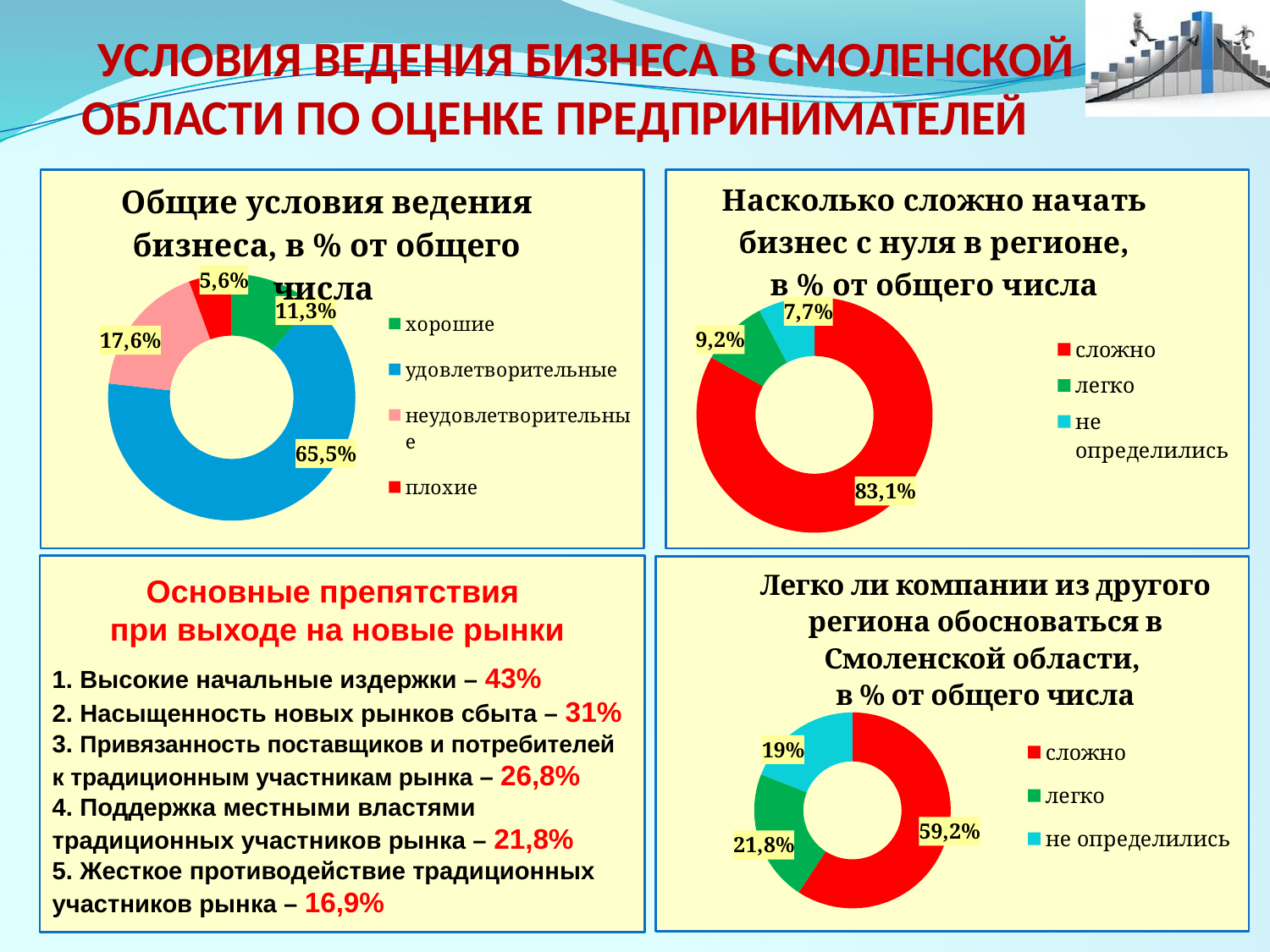
In the top-left chart 'Общие условия ведения бизнеса', which category has the largest share? удовлетворительные In the top-left chart 'Общие условия ведения бизнеса', what is the difference between 'неудовлетворительные' and 'хорошие'? 6,3% In the bottom-right chart 'Легко ли компании из другого региона обосноваться в Смоленской области', what percentage is shown for 'легко'? 21,8% How many categories does the legend of the top-left chart 'Общие условия ведения бизнеса' list? 4 In the bottom-right chart 'Легко ли компании из другого региона обосноваться в Смоленской области', what is the difference between 'сложно' and 'не определились'? 40,2% In the top-right chart 'Насколько сложно начать бизнес с нуля в регионе', what percentage is shown for 'сложно'? 83,1% In the top-right chart 'Насколько сложно начать бизнес с нуля в регионе', which is larger: 'легко' or 'не определились'? легко In the top-left chart 'Общие условия ведения бизнеса', what percentage is shown for 'плохие'? 5,6% In the top-right chart 'Насколько сложно начать бизнес с нуля в регионе', which category has the smallest share? не определились In the top-left chart 'Общие условия ведения бизнеса', what percentage is shown for 'удовлетворительные'? 65,5% In the top-right chart 'Насколько сложно начать бизнес с нуля в регионе', what colour represents 'сложно'? Red What type of chart is the bottom-right chart 'Легко ли компании из другого региона обосноваться в Смоленской области'? Doughnut (pie) chart